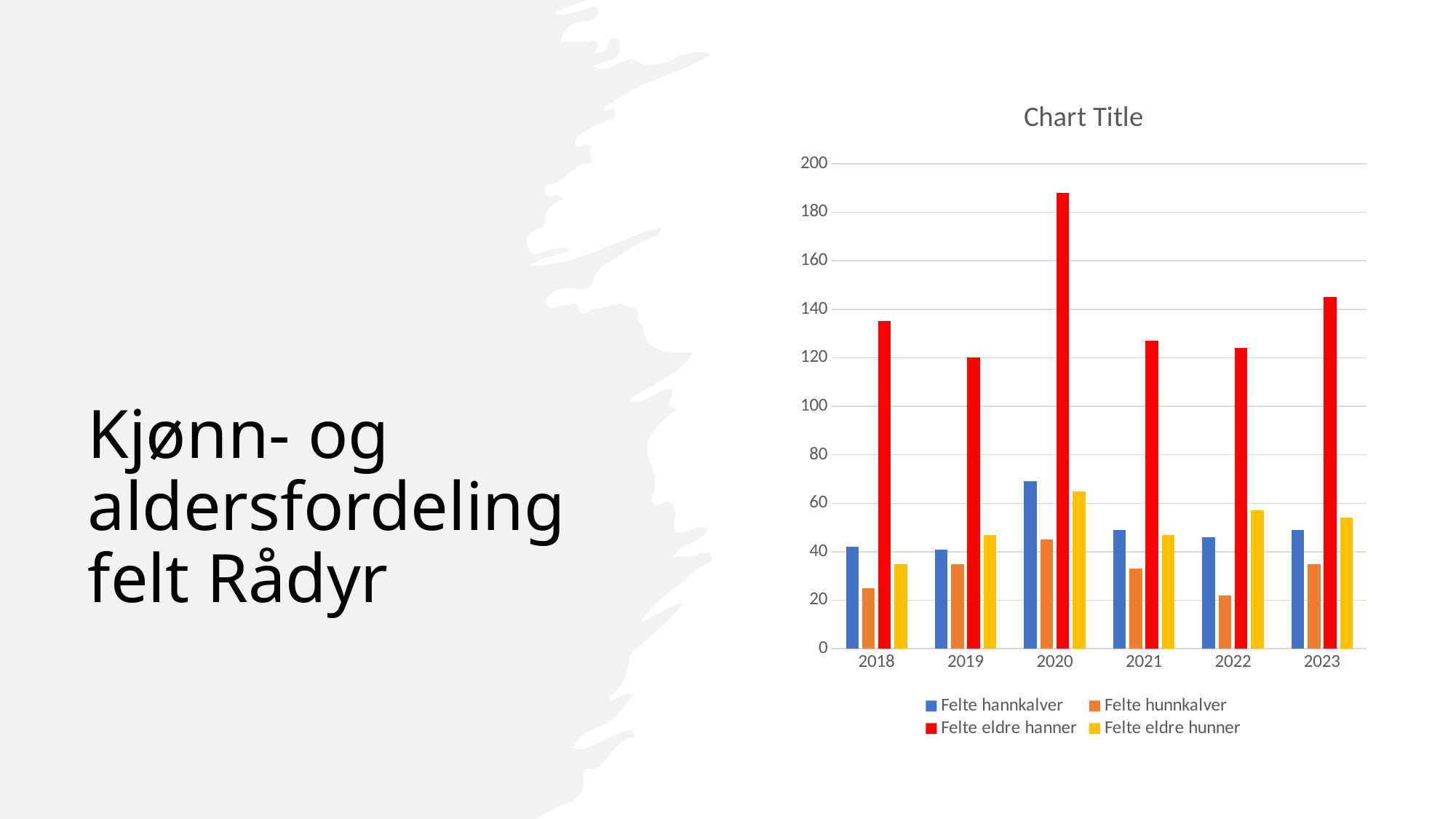
How many series does the legend list? 4 In which year is the value for Felte eldre hanner highest? 2020 What kind of chart is shown on the slide? Bar chart Does the value for Felte eldre hanner rise or fall from 2019 to 2020? rise Is the value for Felte eldre hanner in 2020 greater or less than 180? greater In which year is the value for Felte eldre hunner highest? 2020 What colour are the bars for Felte eldre hanner? Red In which year is the value for Felte hannkalver highest? 2020 Is the value for Felte hunnkalver in 2022 greater or less than 40? less How many years are shown on the x axis? 6 In 2022, which is larger: Felte eldre hunner or Felte hannkalver? Felte eldre hunner Is the value for Felte eldre hanner in 2023 greater or less than 160? less